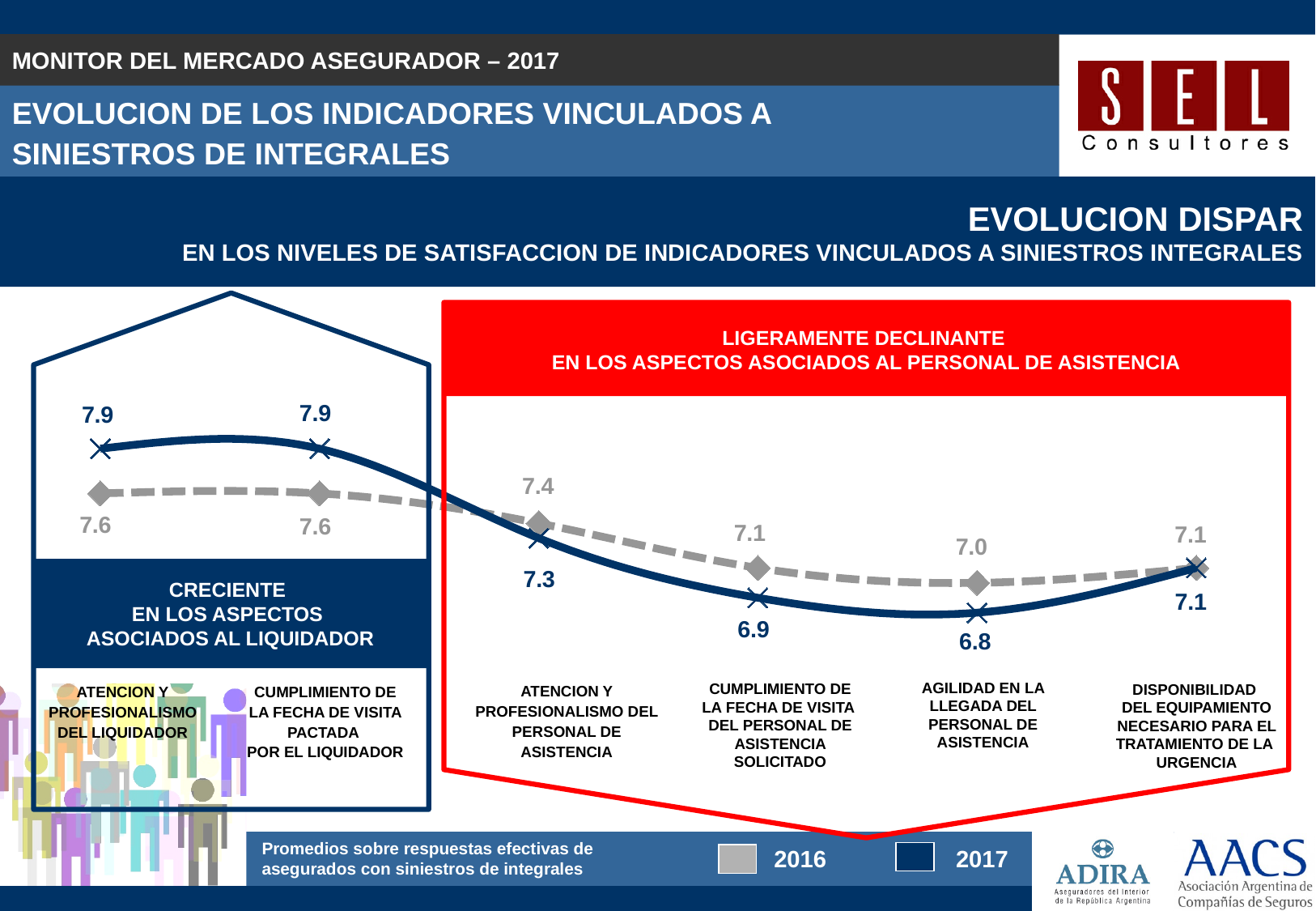
What is the 2016 value for 'Atencion y profesionalismo del personal de asistencia'? 7.4 What is the 2017 value for 'Atencion y profesionalismo del liquidador'? 7.9 What is the 2017 value for 'Cumplimiento de la fecha de visita del personal de asistencia solicitado'? 6.9 How many categories are plotted on the chart? 6 How many series does the legend list? 2 What is the 2016 value for 'Agilidad en la llegada del personal de asistencia'? 7.0 For 'Agilidad en la llegada del personal de asistencia', which year has the higher value, 2016 or 2017? 2016 What kind of chart is shown on the slide? Line chart Which colour represents the 2016 series in the legend? Grey What is the difference between the 2017 and 2016 values for 'Cumplimiento de la fecha de visita pactada por el liquidador'? 0.3 Which category has the lowest 2017 value? Agilidad en la llegada del personal de asistencia What is the 2017 value for 'Disponibilidad del equipamiento necesario para el tratamiento de la urgencia'? 7.1